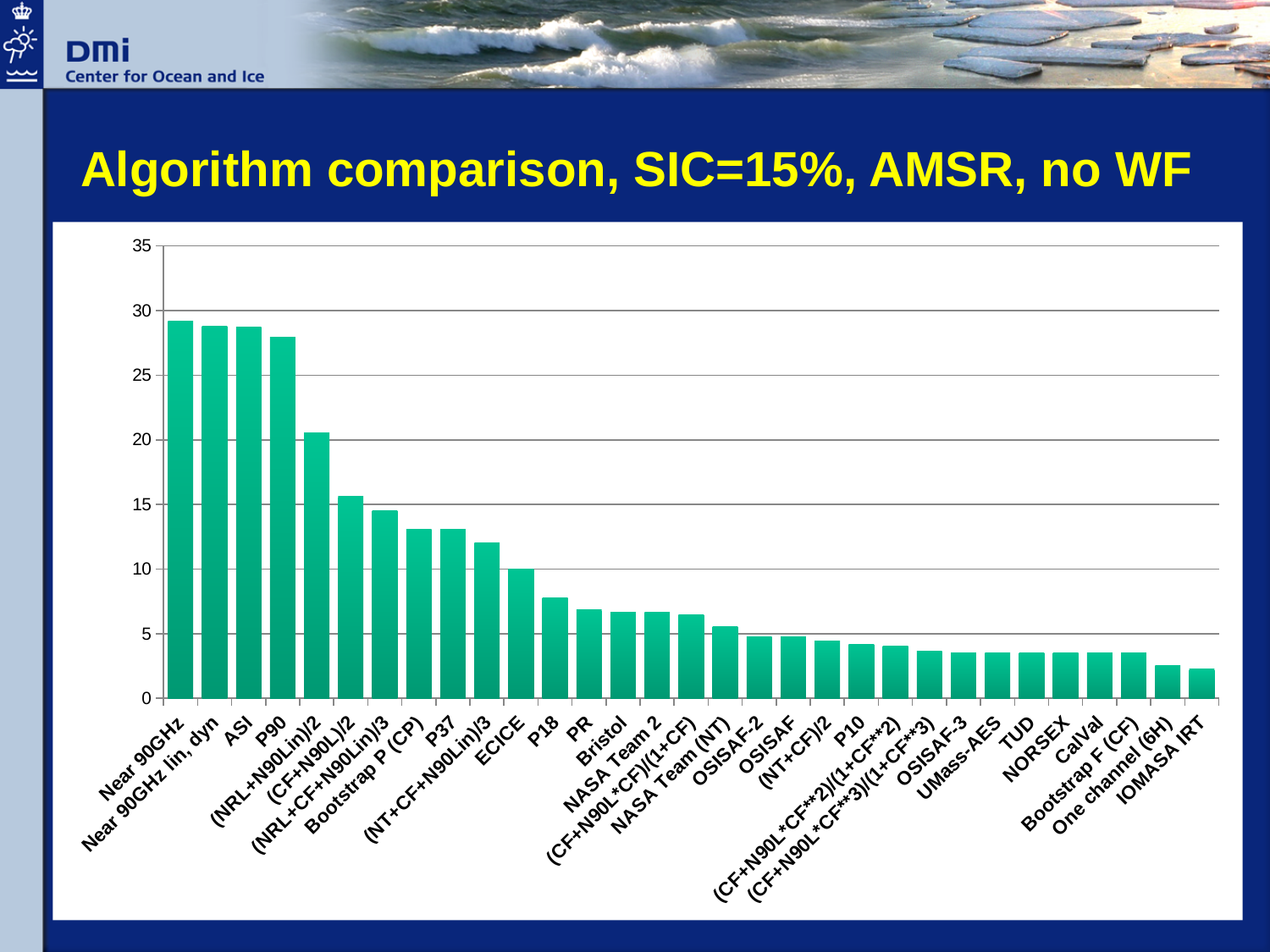
Is the value for (CF+N90L)/2 greater or less than 15? greater Is the value for Bootstrap P (CP) greater or less than 10? greater Is the value for IOMASA IRT greater or less than 5? less What is the title of the chart? Algorithm comparison, SIC=15%, AMSR, no WF How many algorithms (bars) are plotted in the chart? 31 What kind of chart is shown on the slide? bar chart Do the bar values rise or fall from left to right along the x axis? fall Which has the larger value, ASI or ECICE? ASI Which has the larger value, (NRL+N90Lin)/2 or NASA Team (NT)? (NRL+N90Lin)/2